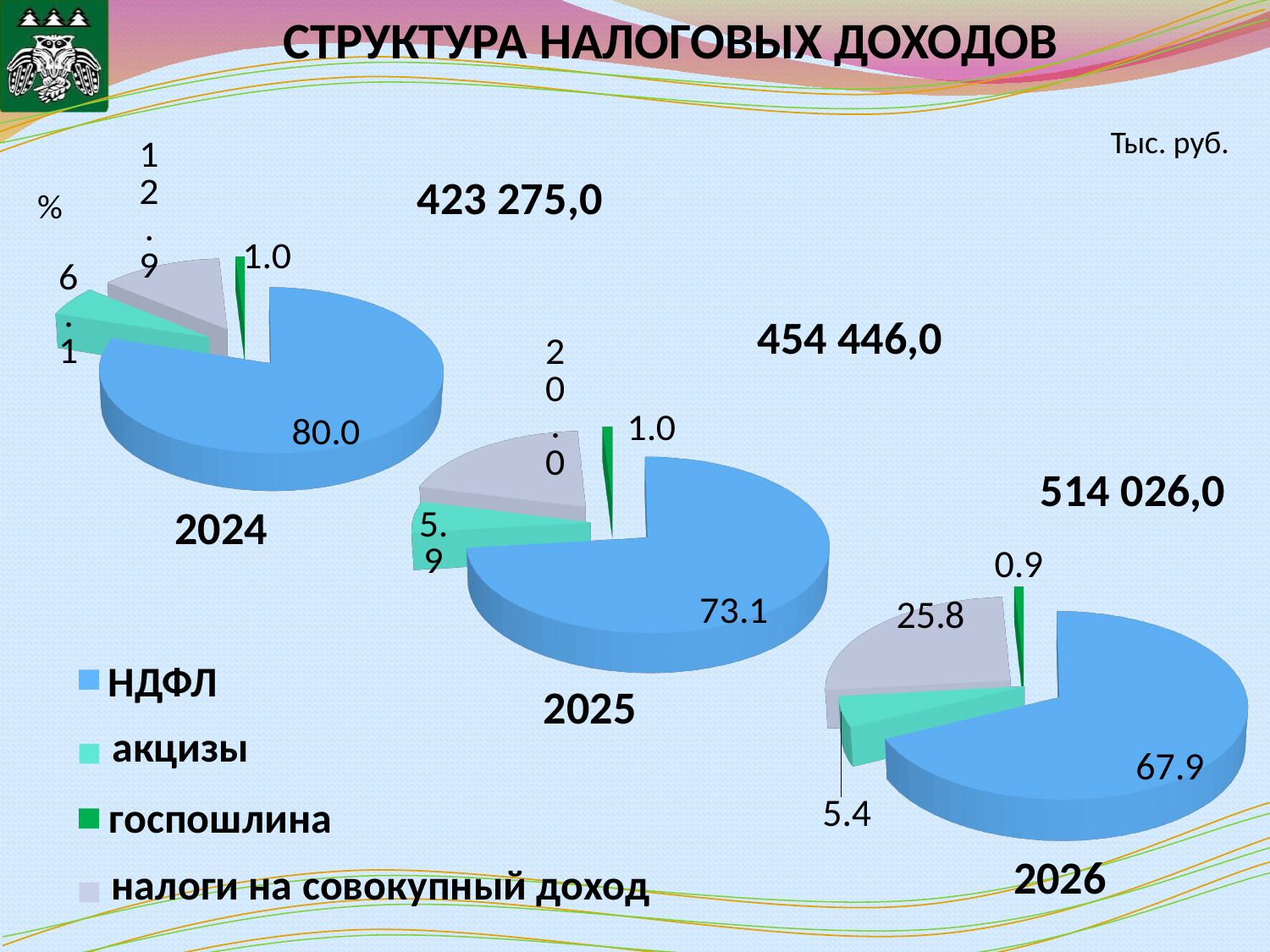
What is the difference between the НДФЛ share in the 2024 chart and the НДФЛ share in the 2026 chart? 12.1 How many categories does each pie chart contain? 4 In the 2025 pie chart, what is the value for налоги на совокупный доход? 20.0 How many entries does the legend list? 4 What kind of charts are shown on the slide? Pie charts In the 2025 pie chart, which category has the smallest share? госпошлина Which is larger: the share of налоги на совокупный доход in the 2025 chart or in the 2026 chart? 2026 In the 2024 pie chart, which category has the largest share? НДФЛ In the 2026 pie chart, what is the value for госпошлина? 0.9 In the 2026 pie chart, what is the value for акцизы? 5.4 In the 2024 pie chart, what share does НДФЛ have? 80.0 What total amount (тыс. руб.) is shown above the 2026 pie chart? 514 026,0